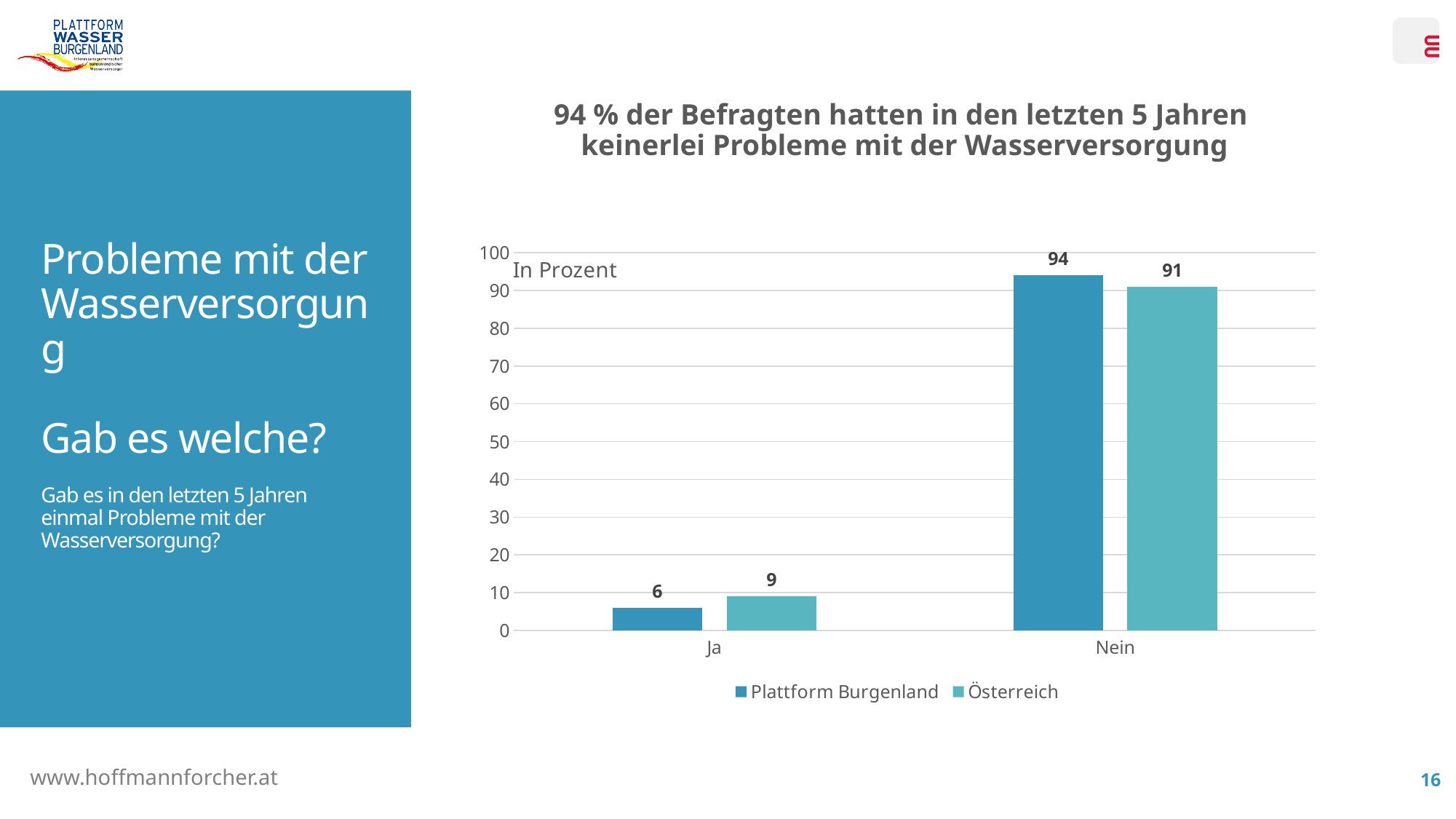
How many categories are shown on the x axis? 2 In the Ja category, which series has the larger value, Plattform Burgenland or Österreich? Österreich What is the value for Plattform Burgenland in the Nein category? 94 What is the value for Österreich in the Ja category? 9 Which category has the highest value for Plattform Burgenland? Nein What kind of chart is shown on the slide? Bar chart What is the value for Österreich in the Nein category? 91 What is the value for Plattform Burgenland in the Ja category? 6 How many series does the legend list? 2 What is the title of the chart? 94 % der Befragten hatten in den letzten 5 Jahren keinerlei Probleme mit der Wasserversorgung Which category has the lowest value for Österreich? Ja What is the difference between Plattform Burgenland and Österreich in the Nein category? 3